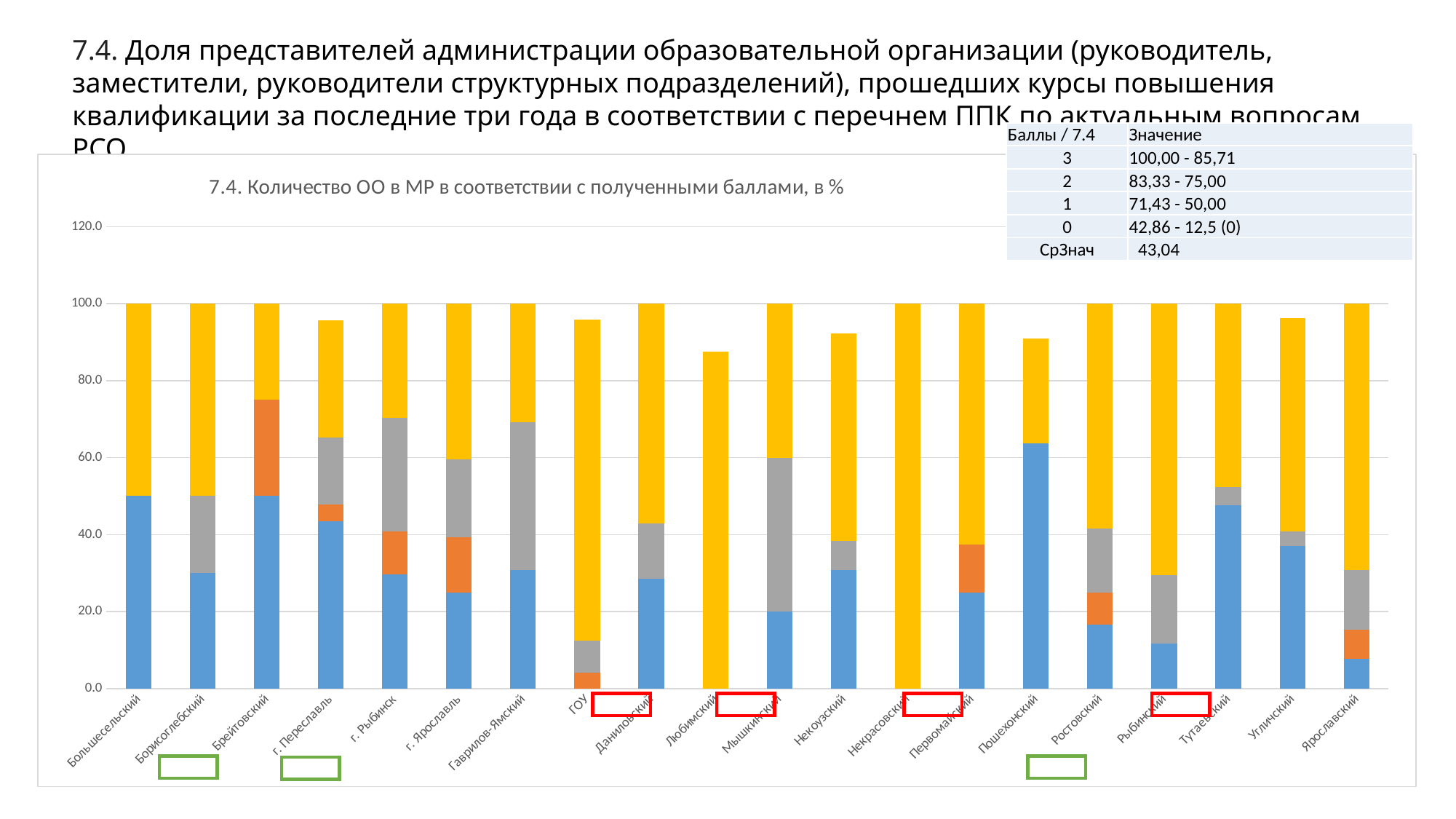
What is the highest value shown on the y axis of the chart? 120.0 How many categories (municipal districts) are shown on the x axis of the chart? 20 Which has the larger blue segment, Большесельский or Борисоглебский? Большесельский What is the title of the chart? 7.4. Количество ОО в МР в соответствии с полученными баллами, в % Is the total height of the bar for Большесельский greater or less than 80? greater What kind of chart is shown on the slide? Stacked bar chart Is the blue segment for Рыбинский greater or less than 20? less Is the blue segment for Пошехонский greater or less than 60? greater Which category has the tallest blue segment? Пошехонский Which has the larger blue segment, Пошехонский or Ярославский? Пошехонский